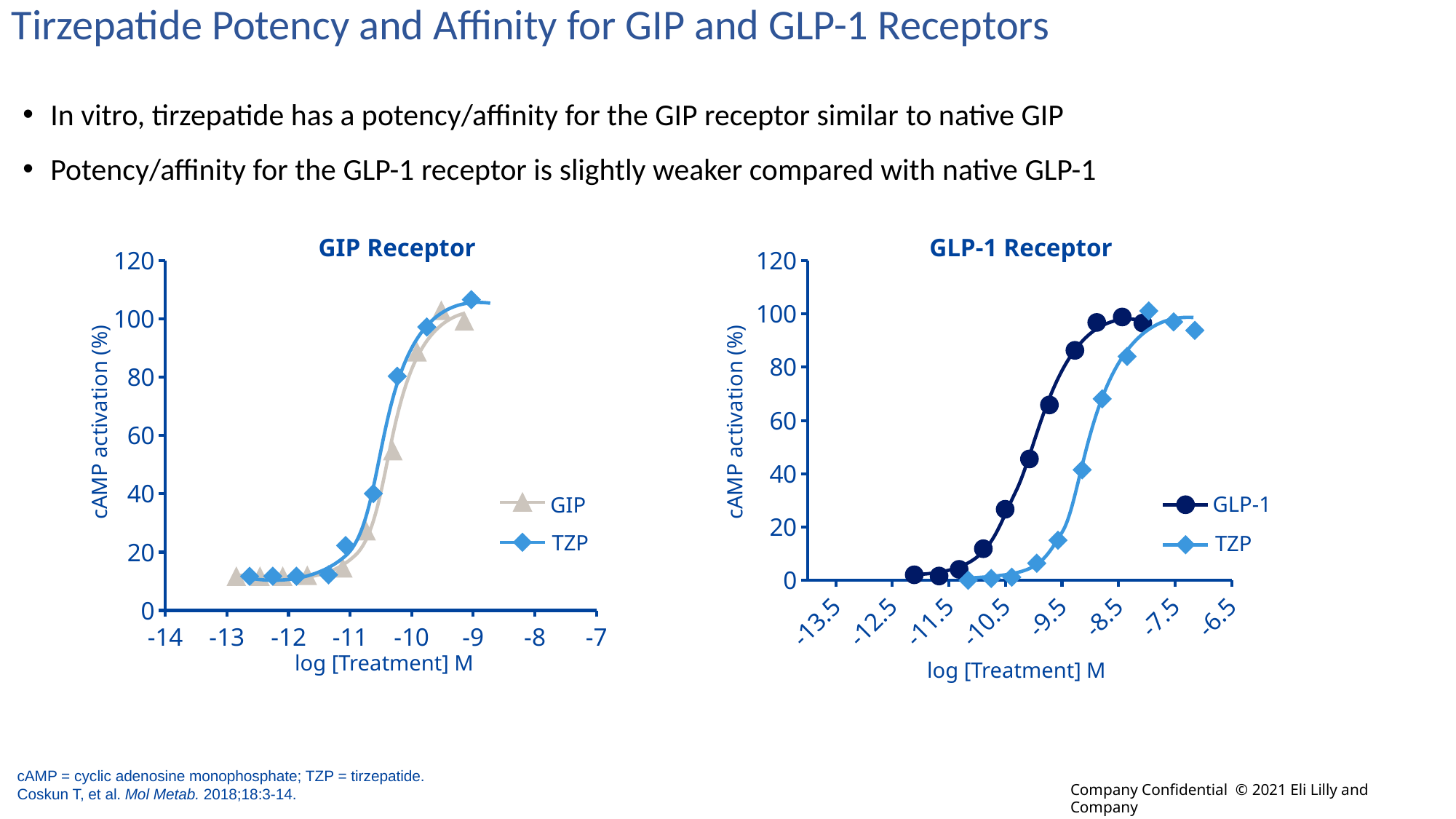
In the GIP Receptor chart, is the TZP value at log [Treatment] M of -10 greater or less than 60? greater In the GLP-1 Receptor chart, do the GLP-1 values rise or fall as log [Treatment] M increases? rise In the GLP-1 Receptor chart, is the GLP-1 value at log [Treatment] M of -9.5 greater or less than 60? greater How many series does the legend of the GLP-1 Receptor chart list? 2 In the GIP Receptor chart, do the TZP values rise or fall as log [Treatment] M increases? rise What are the two series named in the legend of the GIP Receptor chart? GIP and TZP In the GLP-1 Receptor chart, which series has the higher value at log [Treatment] M of -9.5, GLP-1 or TZP? GLP-1 How many series does the legend of the GIP Receptor chart list? 2 What is the y-axis label of the GLP-1 Receptor chart? cAMP activation (%) What kind of chart is the GIP Receptor chart? line chart In the GLP-1 Receptor chart, is the TZP value at log [Treatment] M of -9.5 greater or less than 40? less In the GIP Receptor chart, which series has the higher value at log [Treatment] M of -10, GIP or TZP? TZP